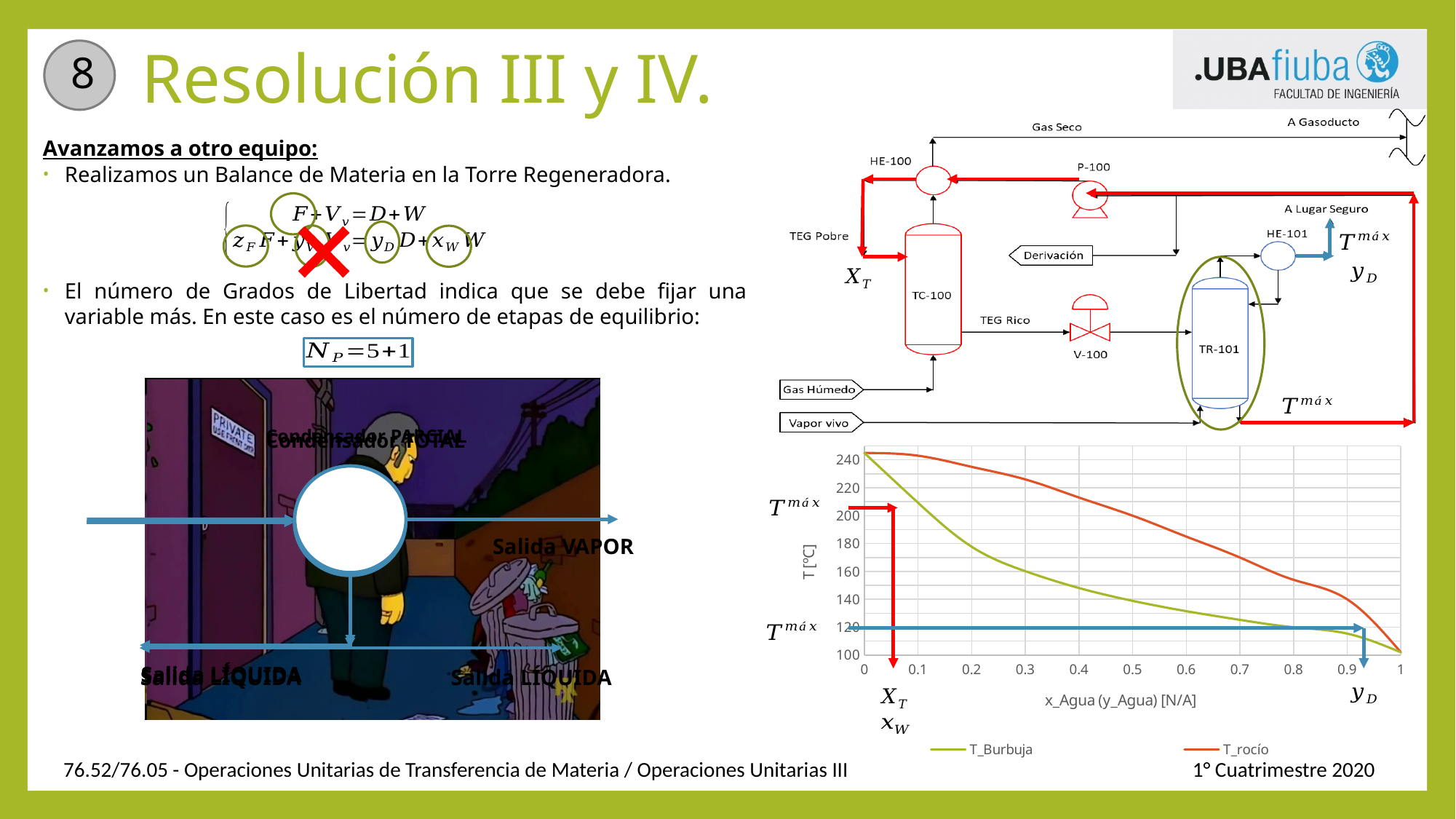
In the bottom-right chart, is the T_Burbuja value at x_Agua = 0.5 greater or less than 180? less What are the two series named in the legend of the bottom-right chart? T_Burbuja and T_rocío What kind of chart is shown at the bottom right of the slide? line chart In the bottom-right chart, which series is higher at x_Agua = 0.5, T_Burbuja or T_rocío? T_rocío In the bottom-right chart, is the T_rocío value at x_Agua = 0.5 greater or less than 180? greater In the bottom-right chart, do the T_rocío values rise or fall as x_Agua increases from 0 to 1? fall What is the label of the x axis of the bottom-right chart? x_Agua (y_Agua) [N/A] In the bottom-right chart, is the T_Burbuja value at x_Agua = 0.8 greater or less than 140? less How many series does the legend of the bottom-right chart list? 2 In the bottom-right chart, do the T_Burbuja values rise or fall as x_Agua increases from 0 to 1? fall